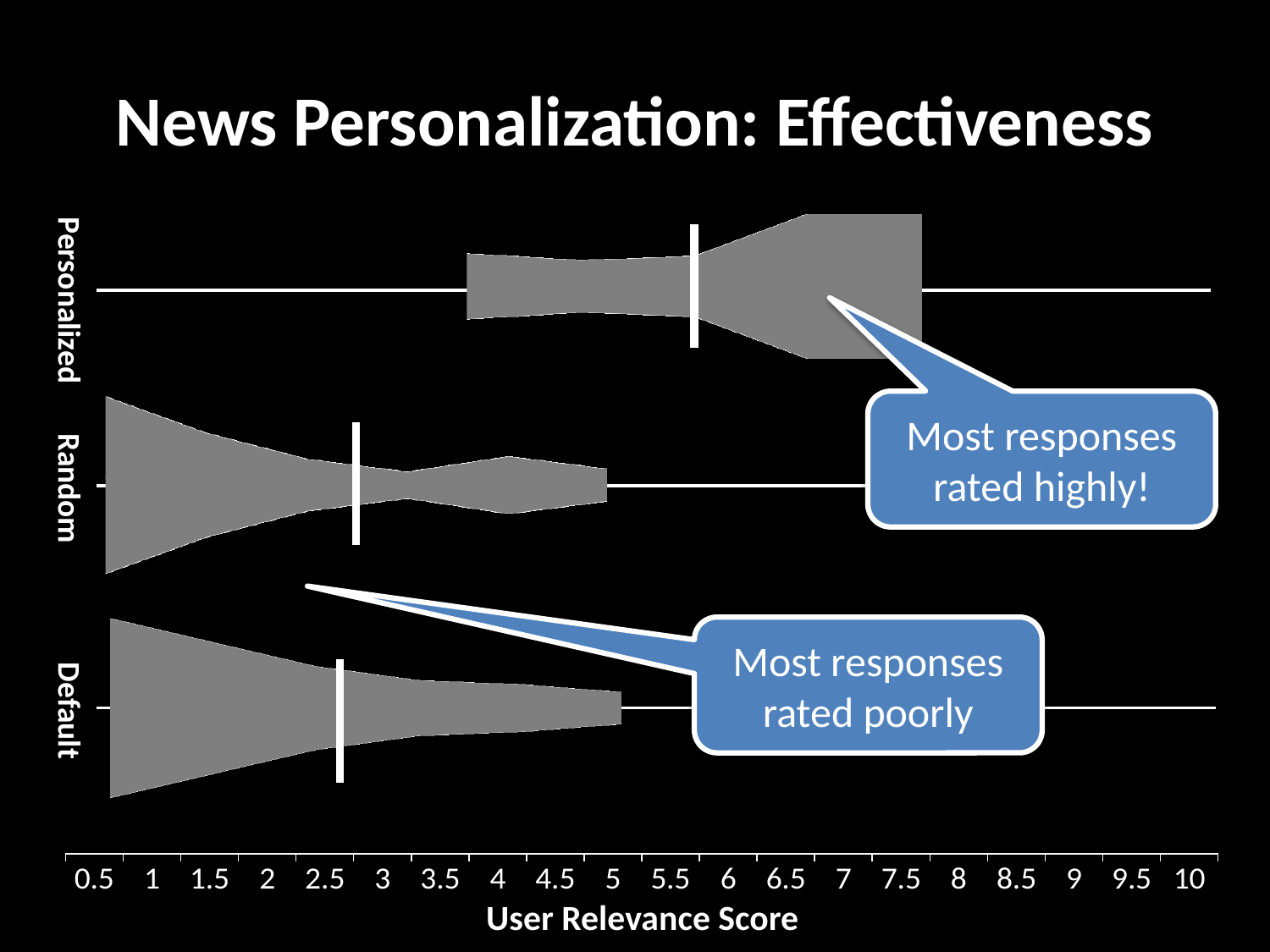
Is the median user relevance score for Personalized greater or less than 5? greater How many categories (conditions) are plotted on the y axis? 3 Which has a higher median user relevance score, Default or Personalized? Personalized What is the label of the x axis? User Relevance Score Is the median user relevance score for Default greater or less than 3? less Which category is listed at the top of the y axis? Personalized What is the highest tick value shown on the x axis? 10 Which has a higher median user relevance score, Personalized or Random? Personalized Is the median user relevance score for Random greater or less than 4? less What is the lowest tick value shown on the x axis? 0.5 Which category has the highest median user relevance score (white marker)? Personalized What is the title of the chart on the slide? News Personalization: Effectiveness